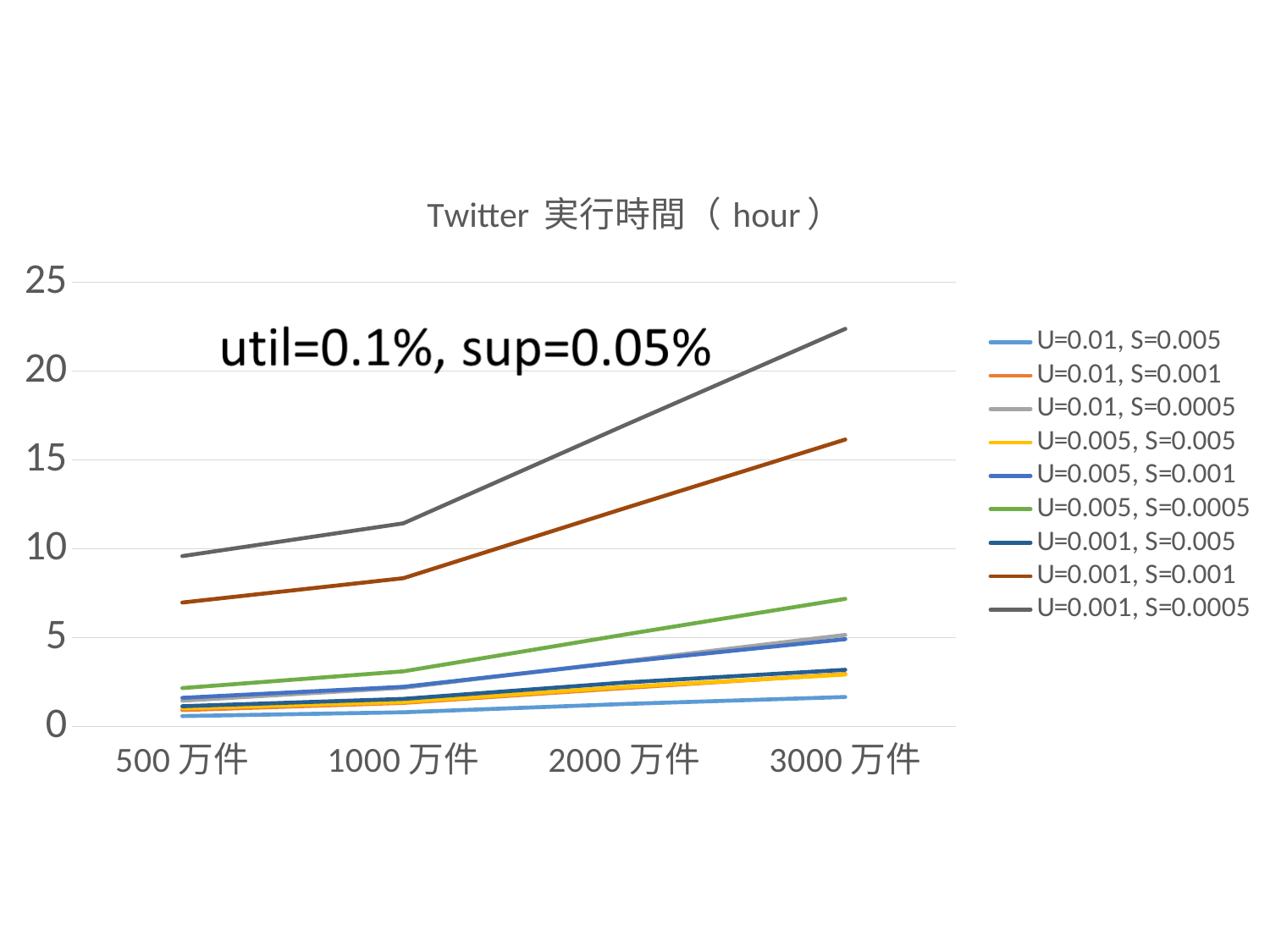
What kind of chart is shown on the slide? line chart Is the value for U=0.001, S=0.001 at 500万件 greater or less than 5? greater How many series does the legend list? 9 What is the title of the chart? Twitter 実行時間（hour） Is the value for U=0.001, S=0.0005 at 3000万件 greater or less than 20? greater How many categories are shown on the x axis? 4 Which is larger at 2000万件: U=0.001, S=0.0005 or U=0.001, S=0.001? U=0.001, S=0.0005 Which series has the highest value at 3000万件? U=0.001, S=0.0005 Is the value for U=0.005, S=0.0005 at 3000万件 greater or less than 10? less Do the values for U=0.001, S=0.0005 rise or fall from 500万件 to 3000万件? rise What parameter annotation is written inside the chart area? util=0.1%, sup=0.05% Which series has the lowest value at 3000万件? U=0.01, S=0.005